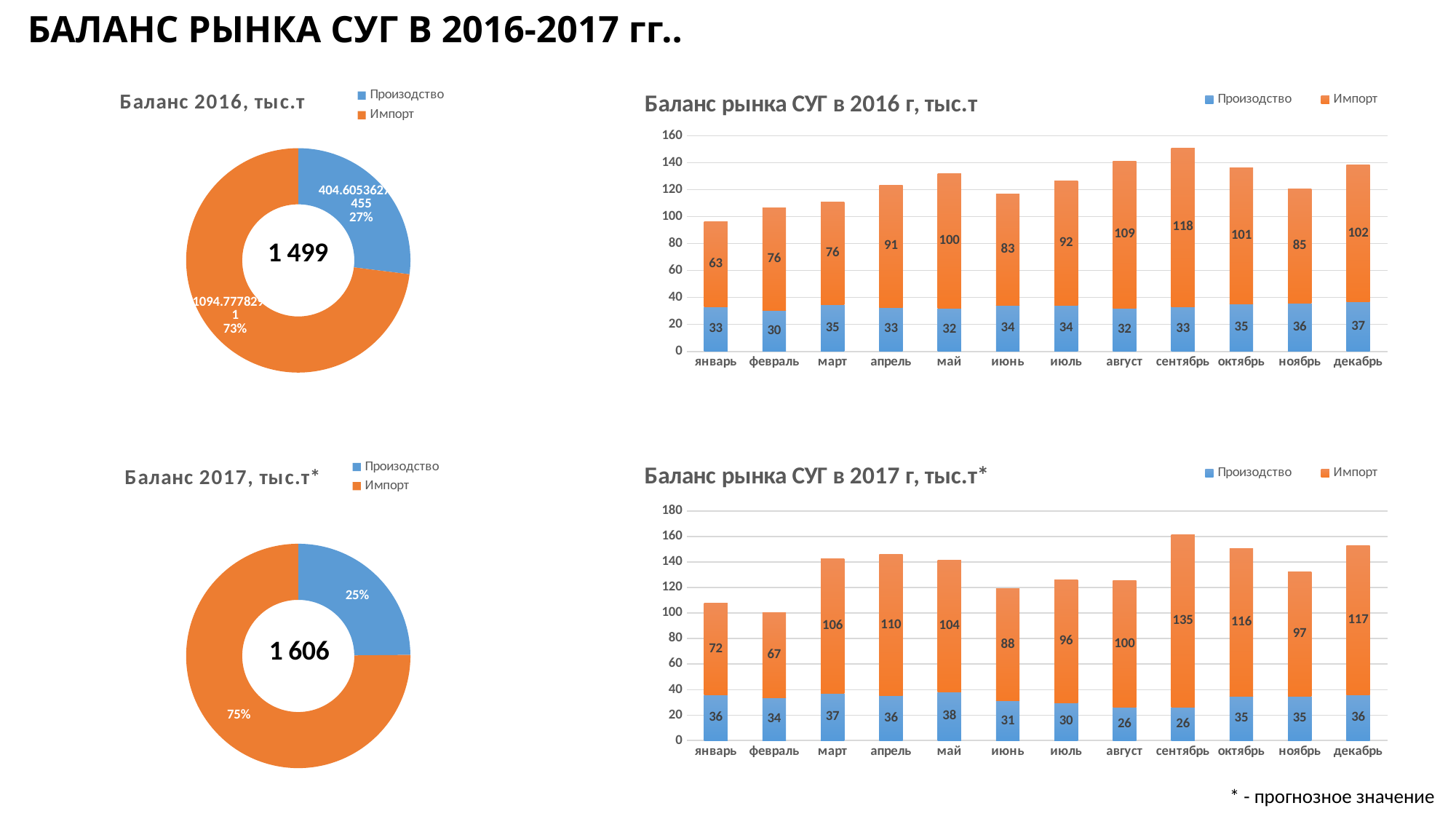
In the chart 'Баланс рынка СУГ в 2016 г, тыс.т', what is the Импорт value for сентябрь? 118 In the chart 'Баланс рынка СУГ в 2016 г, тыс.т', what is the total of the stacked bar for декабрь? 139 In the chart 'Баланс рынка СУГ в 2016 г, тыс.т', which month has the highest Импорт value? сентябрь What total value is shown in the centre of the chart 'Баланс 2016, тыс.т'? 1 499 In the chart 'Баланс 2017, тыс.т*', what share of the total does Импорт have? 75% In the chart 'Баланс рынка СУГ в 2017 г, тыс.т*', what is the difference between the Импорт values for сентябрь and январь? 63 In the chart 'Баланс рынка СУГ в 2017 г, тыс.т*', how many series does the legend list? 2 In the chart 'Баланс рынка СУГ в 2017 г, тыс.т*', which month has the lowest Импорт value? февраль In the chart 'Баланс рынка СУГ в 2017 г, тыс.т*', what is the Производство value for май? 38 What kind of chart is 'Баланс 2016, тыс.т'? Pie (doughnut) chart In the chart 'Баланс рынка СУГ в 2017 г, тыс.т*', which month has the larger Импорт value, март or апрель? апрель In the chart 'Баланс рынка СУГ в 2016 г, тыс.т', how many months are shown on the x axis? 12